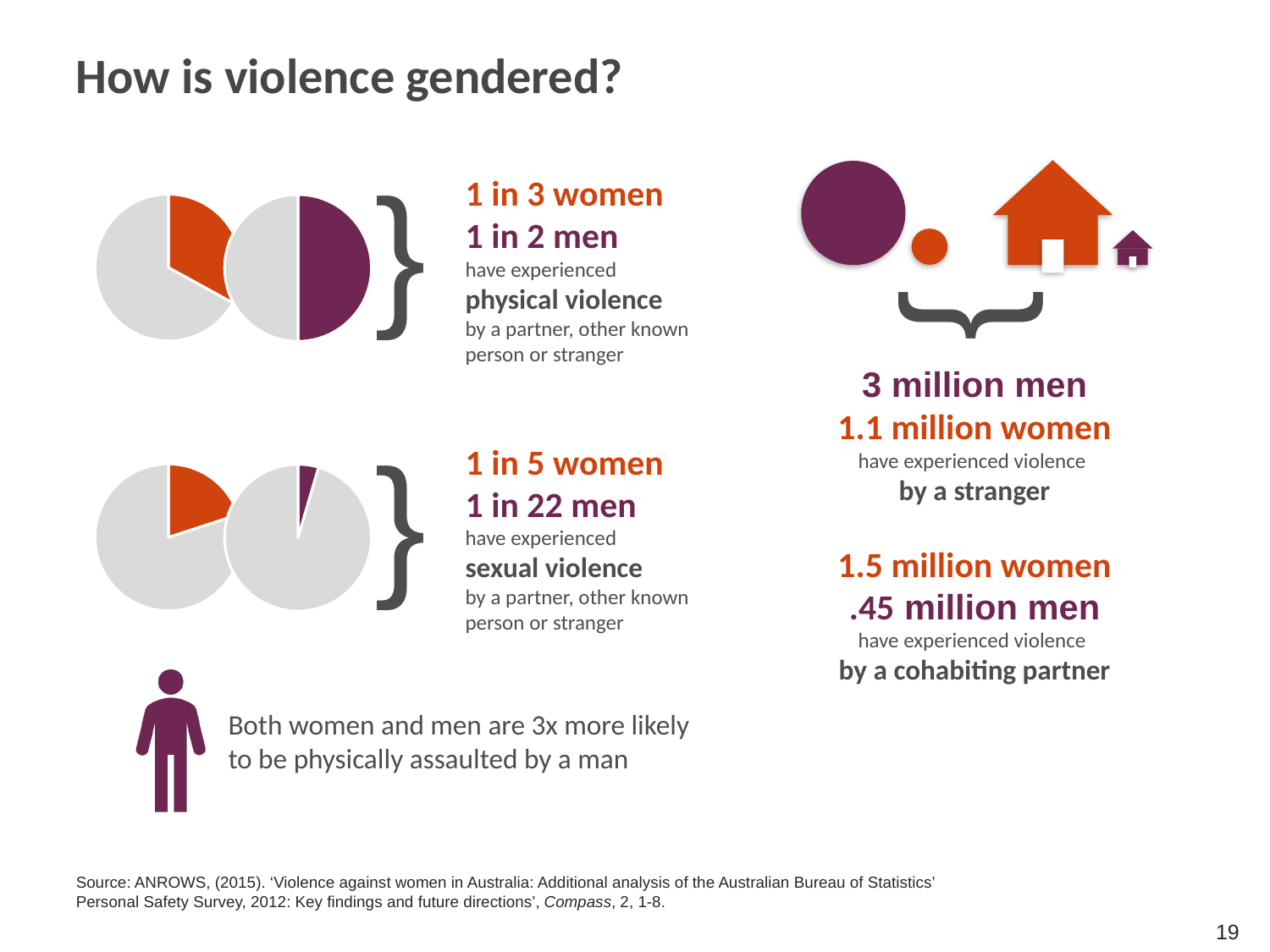
In the physical violence pie charts, what share of women have experienced physical violence by a partner, other known person or stranger? 1 in 3 In the pie charts, what colour is used for the women's slice? Orange In the physical violence pie charts, which group has the larger highlighted share, women or men? Men How many pie charts are shown on the slide? 4 According to the infographic on the right, how many women have experienced violence by a cohabiting partner? 1.5 million What kind of charts are used on the left side of the slide to show the proportions of women and men who have experienced violence? Pie charts In the sexual violence pie charts, what share of women have experienced sexual violence? 1 in 5 In the sexual violence pie charts, which group has the larger highlighted share, women or men? Women In the physical violence pie charts, what share of men have experienced physical violence by a partner, other known person or stranger? 1 in 2 In the pie charts, what colour is used for the men's slice? Purple According to the infographic on the right, how many men have experienced violence by a stranger? 3 million